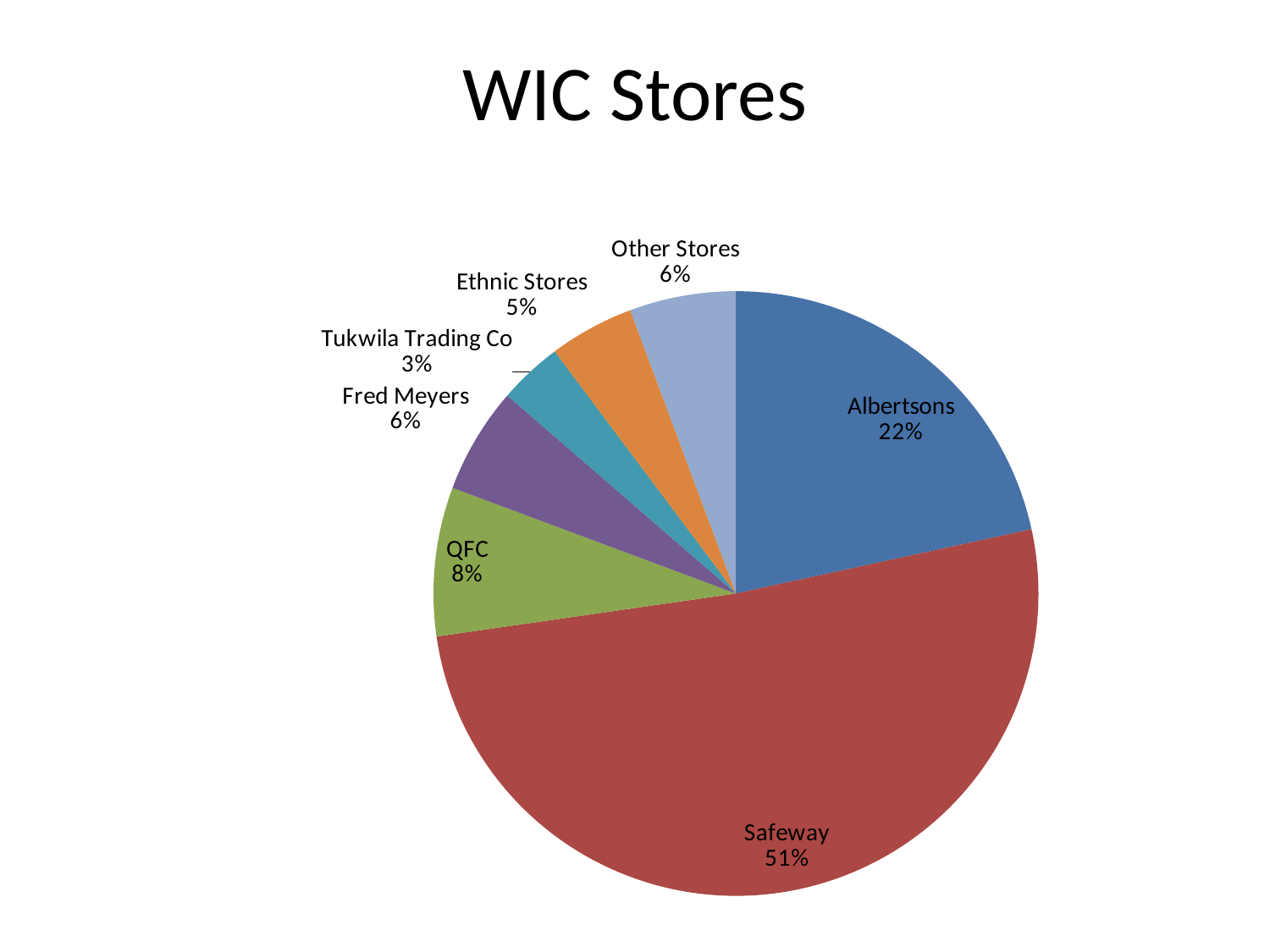
What is the difference between the Safeway and Albertsons percentages? 29% Which store has the largest slice of the pie? Safeway How many slices does the pie chart have? 7 What kind of chart is shown on the slide? Pie chart What is the value shown for Albertsons? 22% What percentage is shown for QFC? 8% What share of the pie does Safeway have? 51% What is the value for Tukwila Trading Co? 3% What is the combined share of Fred Meyers and Other Stores? 12% Which category has the smallest slice of the pie? Tukwila Trading Co Which is larger, the share for QFC or the share for Ethnic Stores? QFC What is the title of the chart? WIC Stores